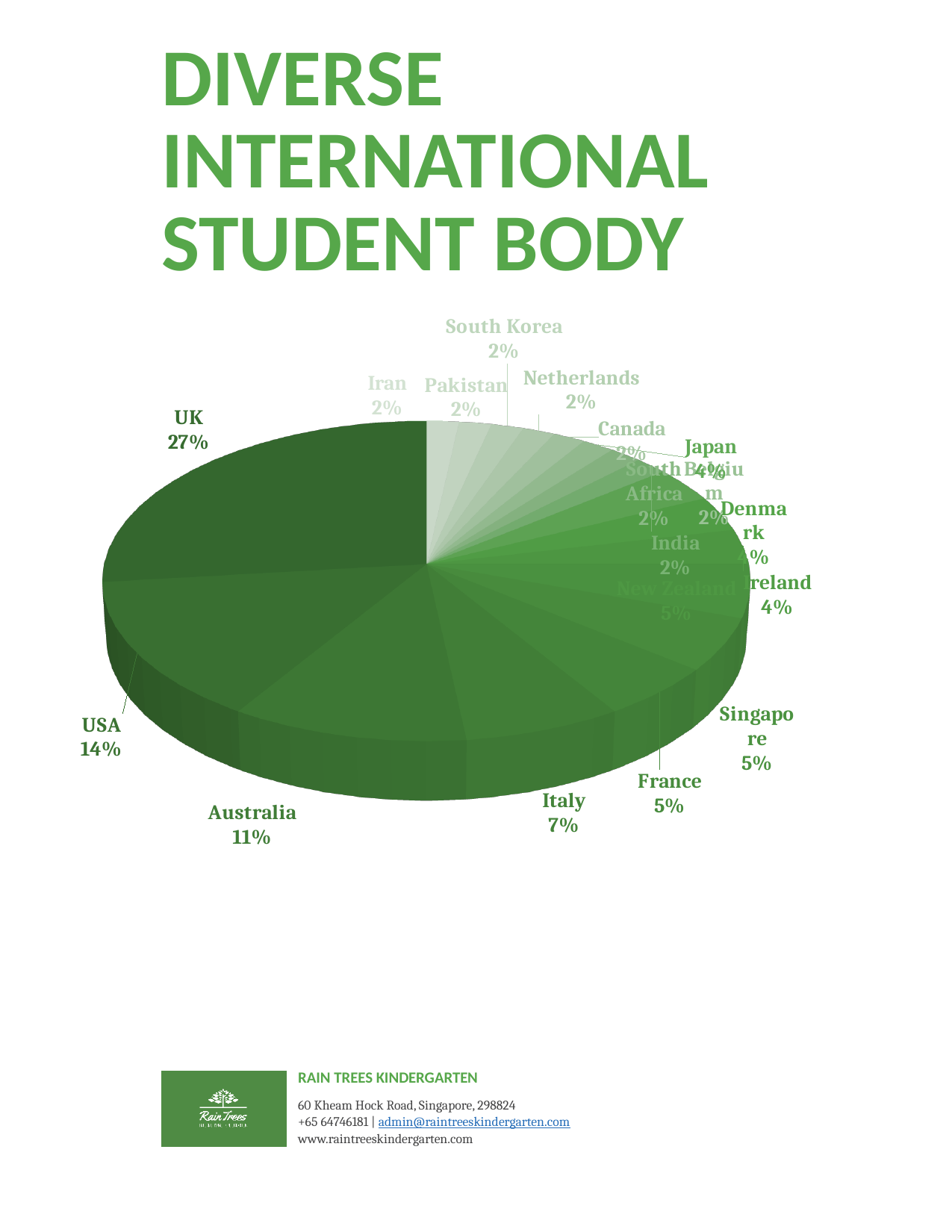
Which country has the largest share of the international student body? UK What kind of chart is shown on the slide? pie chart What percentage of the student body is from Ireland? 4% What percentage of the student body is from the USA? 14% What is the title of the slide containing the chart? DIVERSE INTERNATIONAL STUDENT BODY What percentage of the student body is from New Zealand? 5% What is the difference in percentage points between the UK and USA shares? 13% What share of the pie does the France slice represent? 5% What percentage of the student body is from Australia? 11% What percentage of the student body is from the UK? 27% What percentage of the student body is from Italy? 7% Which has a larger share, Australia or Italy? Australia